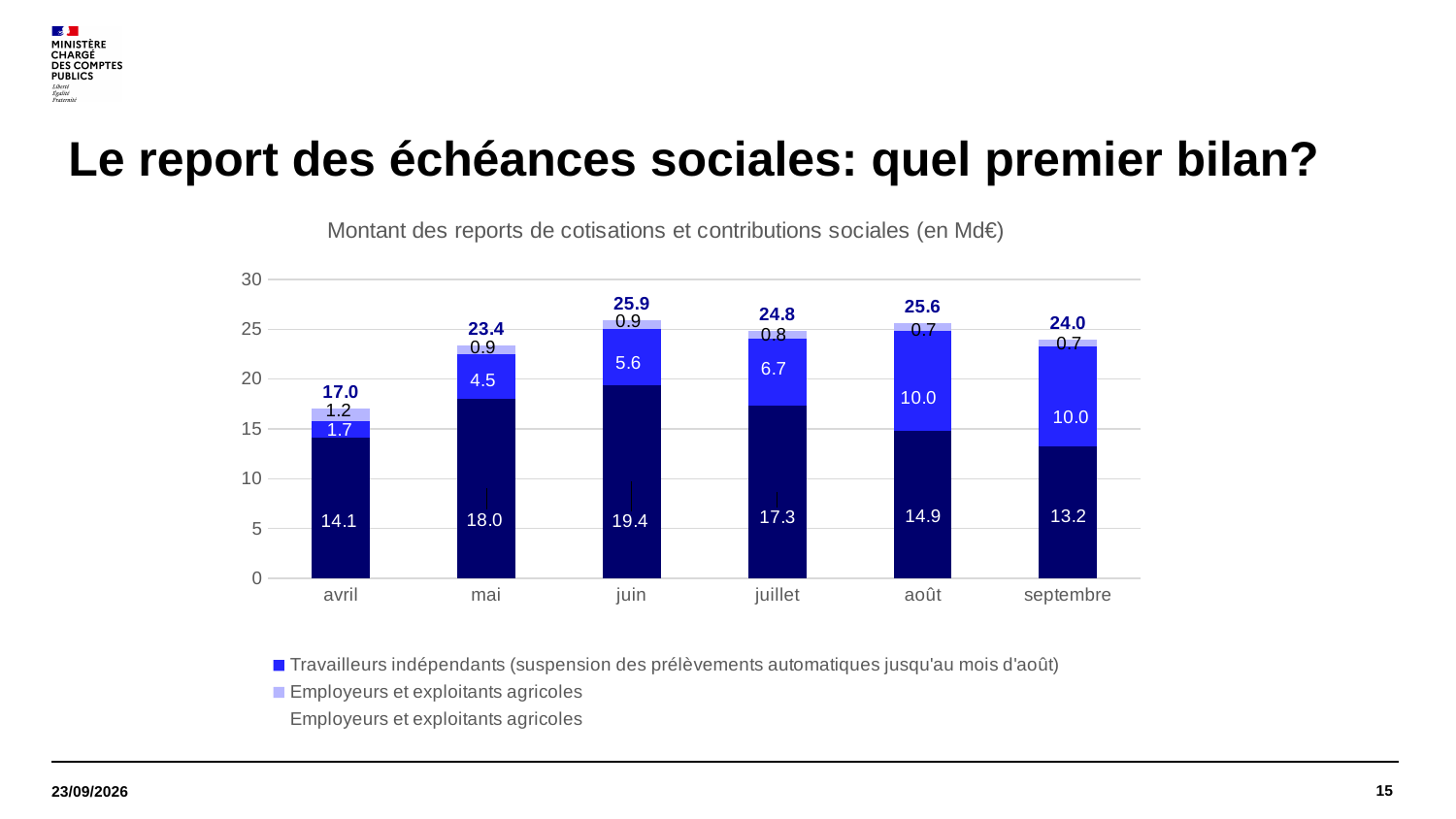
Is the total for mai greater or less than 20? greater Does the value for Travailleurs indépendants rise or fall from avril to août? Rises What kind of chart is shown on the slide? Stacked bar chart What is the title of the chart? Montant des reports de cotisations et contributions sociales (en Md€) What is the difference between the total for juin and the total for avril? 8.9 How many months are shown on the x axis of the chart? 6 What is the value of the dark navy bottom segment for juin? 19.4 Which month has the lowest total amount of reports? avril Which month has the highest total amount of reports? juin What is the total amount shown above the bar for juin? 25.9 Is the value for Travailleurs indépendants larger in juillet or in mai? juillet What is the value for Travailleurs indépendants in août? 10.0